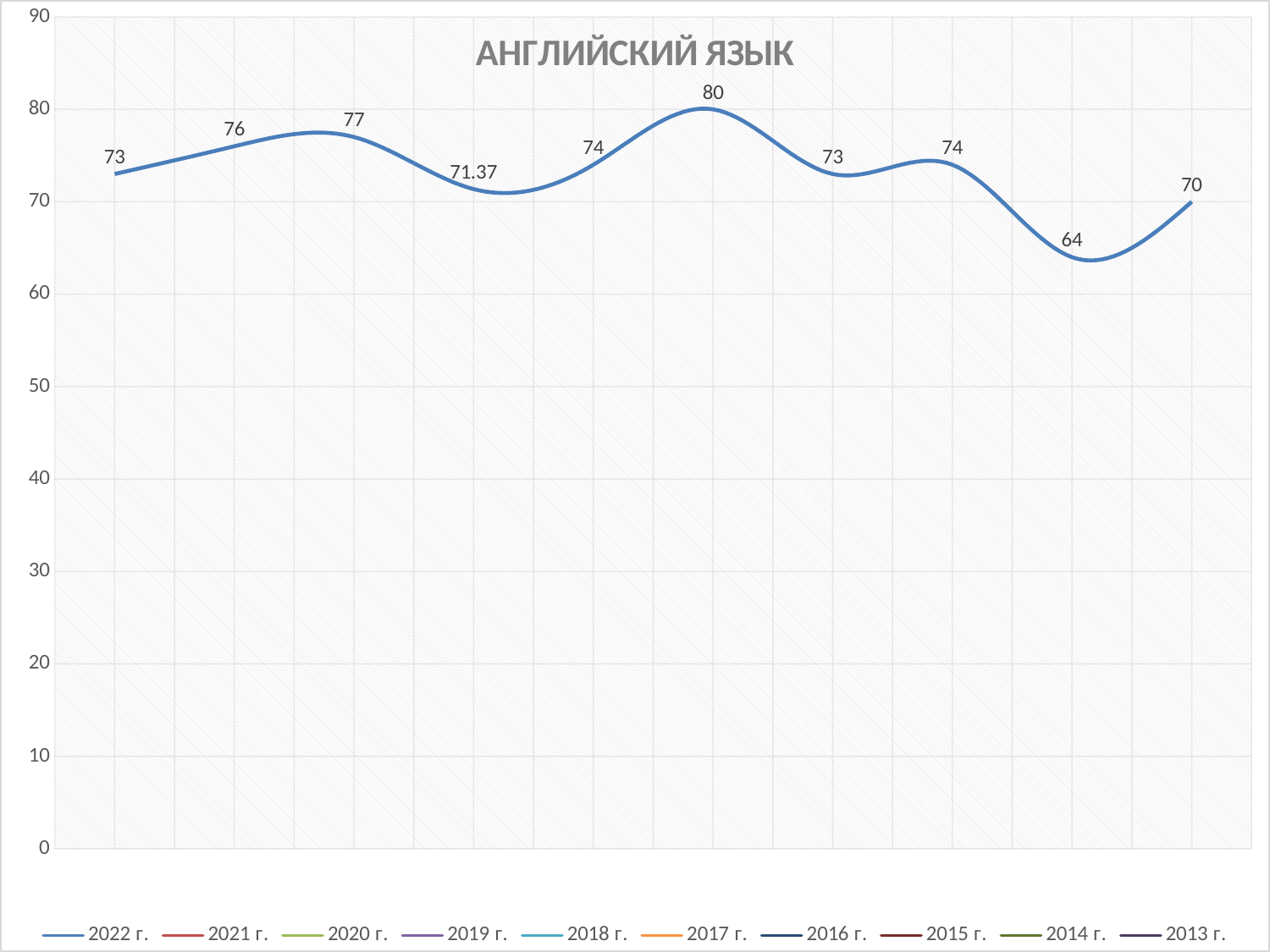
What is the lowest value labelled on the line? 64 Is the lowest point on the line greater or less than 60? greater What is the difference between the highest and lowest labelled values on the line? 16 What is the title of the chart? АНГЛИЙСКИЙ ЯЗЫК What is the value of the fourth point from the left on the line? 71.37 What kind of chart is shown on the slide? line chart Which is larger, the second point from the left (76) or the third point from the left (77)? 77 What is the value of the last (rightmost) point on the line? 70 How many data points are labelled on the line? 10 How many entries does the legend list? 10 What is the value of the first (leftmost) point on the line? 73 What is the highest value labelled on the line? 80